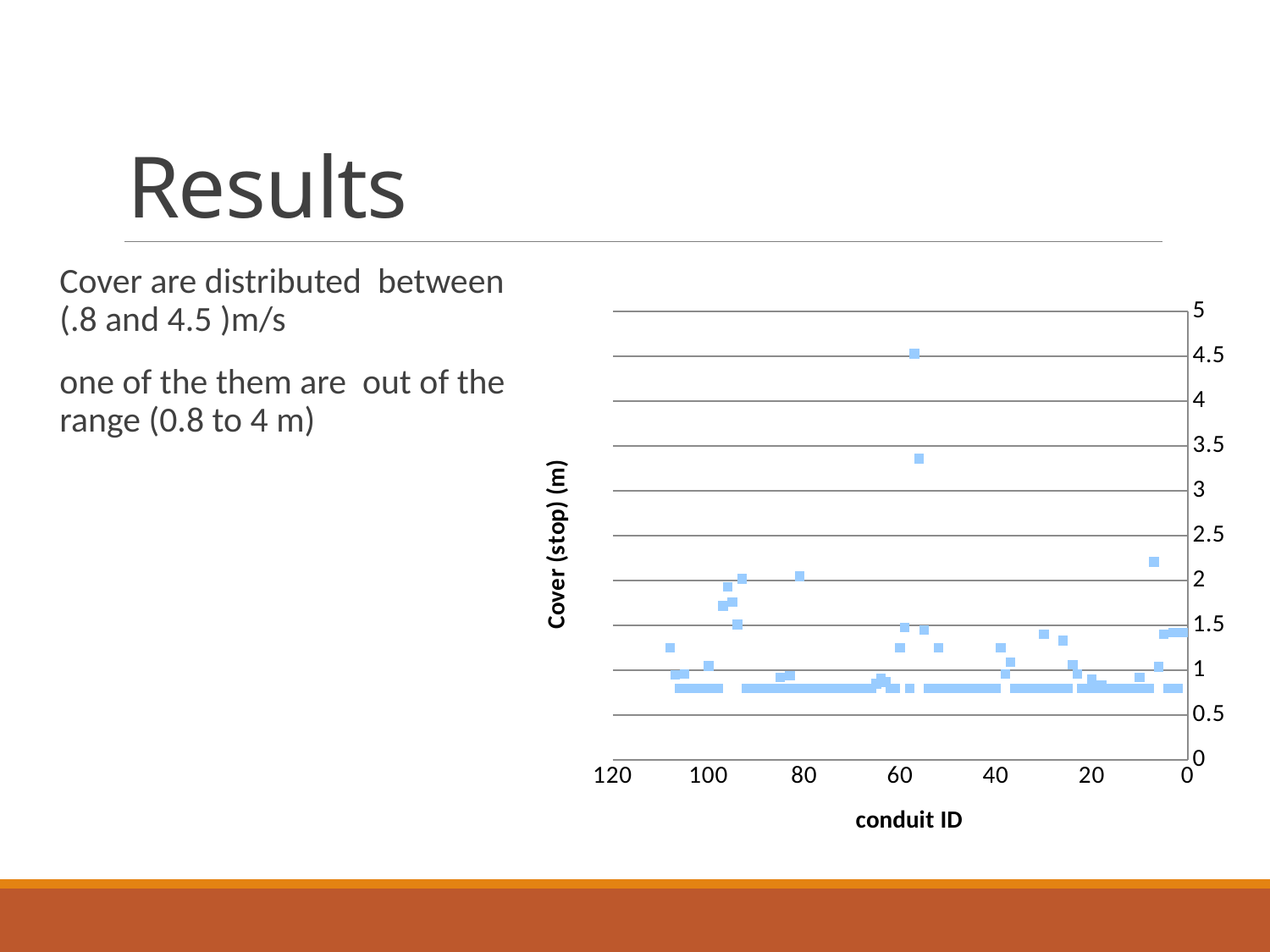
What is the title of the vertical axis of the chart? Cover (stop) (m) Is the second-highest plotted cover value greater or less than 3? greater What kind of chart is shown on the slide? scatter chart Is the lowest plotted cover value greater or less than 0.5? greater Is the highest plotted point in the conduit ID range 0 to 20 greater or less than 2.5? less What is the title of the horizontal axis of the chart? conduit ID